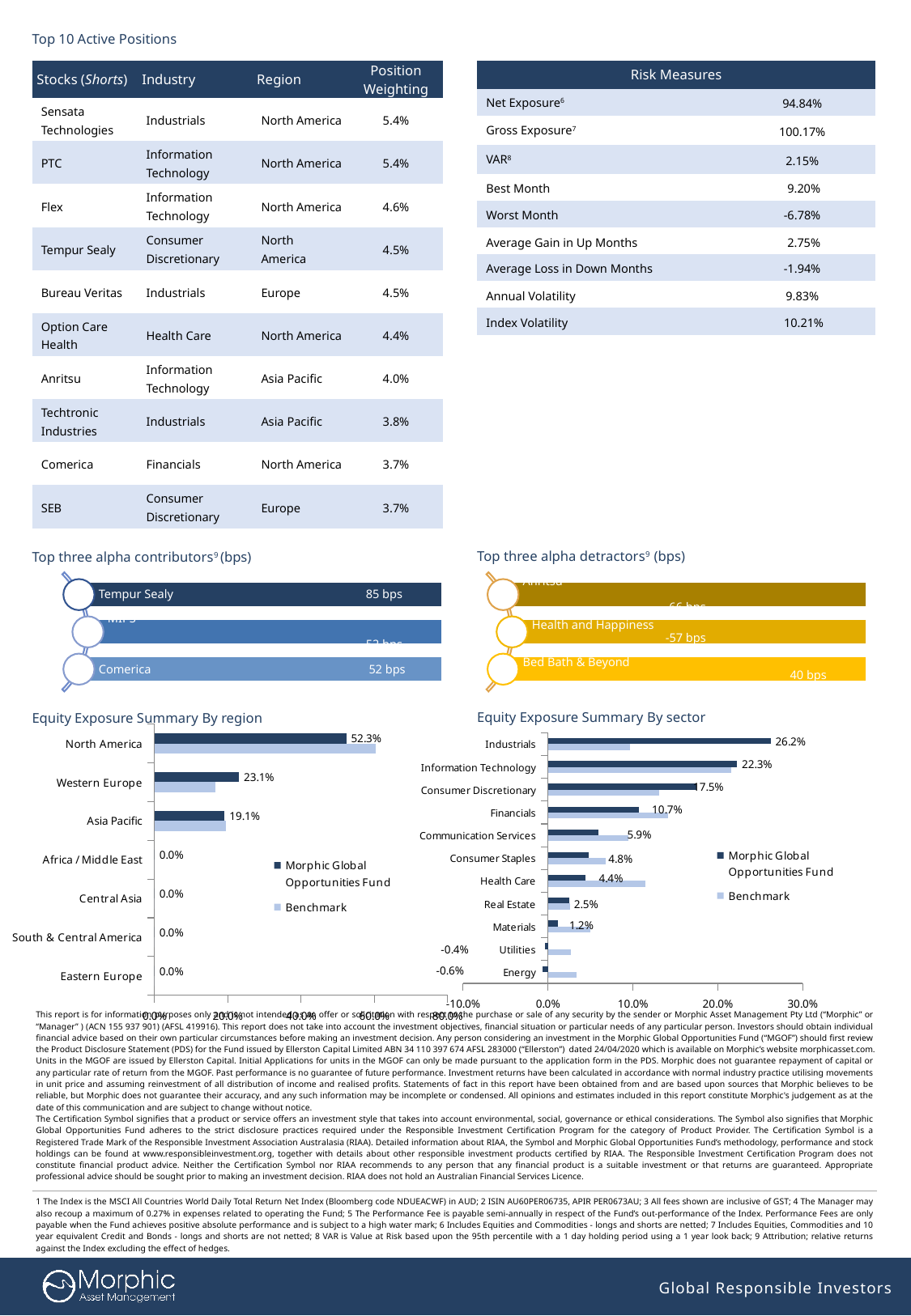
How many series does the legend of the Equity Exposure Summary By region chart list? 2 How many sectors are shown in the Equity Exposure Summary By sector chart? 11 In the Equity Exposure Summary By region chart, which region has the highest fund exposure? North America In the Equity Exposure Summary By sector chart, what is the fund's exposure to Health Care? 4.4% In the Equity Exposure Summary By region chart, what is the Morphic Global Opportunities Fund's exposure to North America? 52.3% In the Equity Exposure Summary By sector chart, what is the difference between the fund's Industrials and Information Technology exposures? 3.9% In the Equity Exposure Summary By sector chart, which sector has the lowest fund exposure? Energy In the Equity Exposure Summary By region chart, what is the difference between the fund's North America and Western Europe exposures? 29.2% In the Equity Exposure Summary By region chart, is the Benchmark value for North America greater or less than 40.0%? greater What type of chart is the Equity Exposure Summary By sector chart? Bar chart In the Equity Exposure Summary By sector chart, what is the Morphic Global Opportunities Fund's exposure to Industrials? 26.2% In the Equity Exposure Summary By sector chart, which is larger for the fund: Financials or Consumer Discretionary? Consumer Discretionary